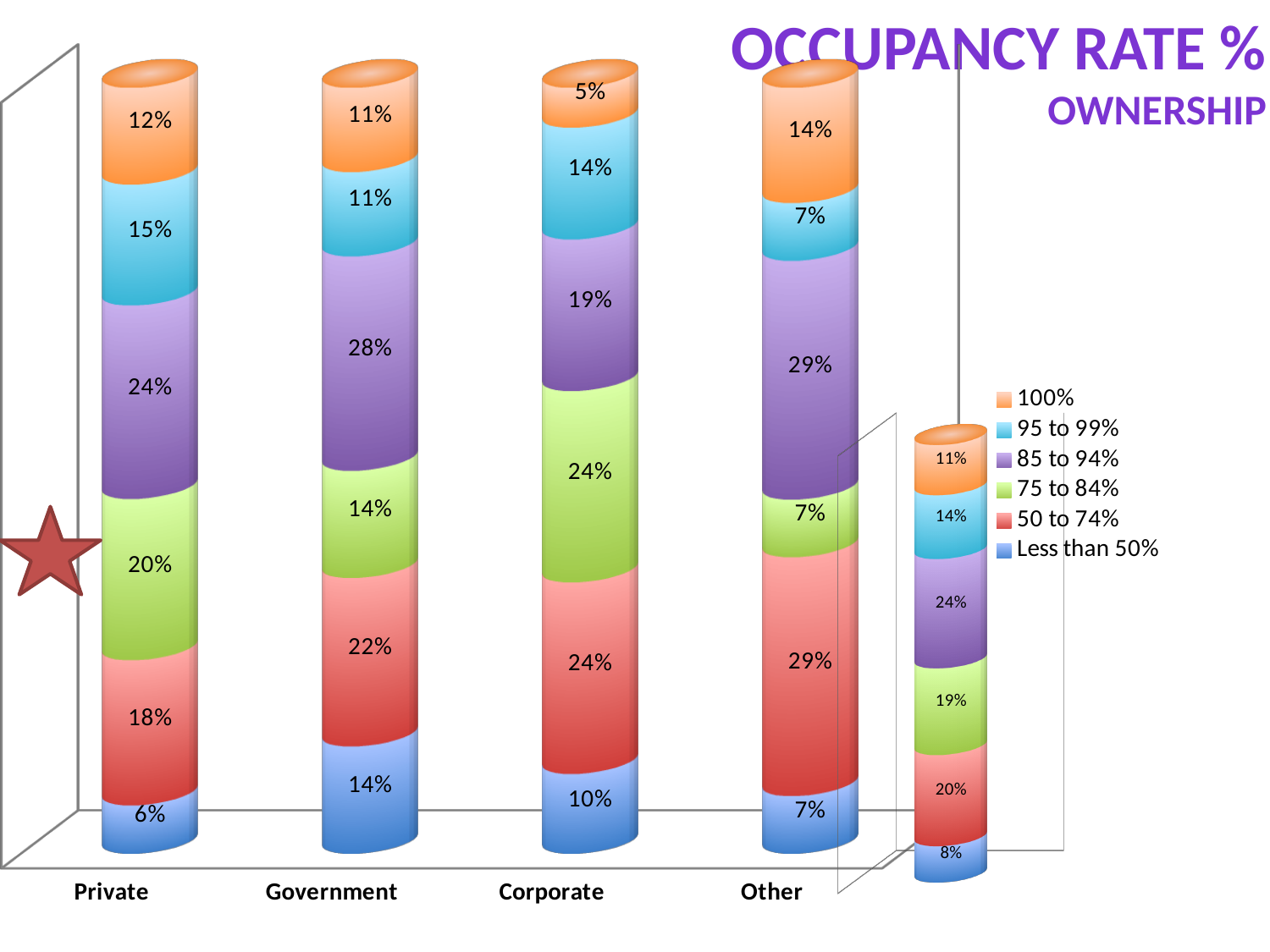
In the main Occupancy Rate % Ownership chart, which is larger: the Less than 50% value for Government or for Private? Government What kind of chart is the Occupancy Rate % Ownership chart? Stacked bar chart In the main Occupancy Rate % Ownership chart, what is the value of the 85 to 94% segment for Government? 28% How many series does the legend of the Occupancy Rate % Ownership chart list? 6 In the main Occupancy Rate % Ownership chart, what is the value of the 100% segment for Other? 14% In the small chart at the bottom right of the slide, what is the value of the bottom (Less than 50%) segment? 8% In the main Occupancy Rate % Ownership chart, which category has the highest value for the 50 to 74% segment? Other Which legend entry in the Occupancy Rate % Ownership chart is shown in purple? 85 to 94% How many ownership categories are labelled on the x axis of the main Occupancy Rate % Ownership chart? 4 In the main Occupancy Rate % Ownership chart, which category has the lowest value for the 100% segment? Corporate In the main Occupancy Rate % Ownership chart, what is the difference between the 75 to 84% values for Corporate and Other? 17% In the main Occupancy Rate % Ownership chart, what is the value of the Less than 50% segment for Corporate? 10%